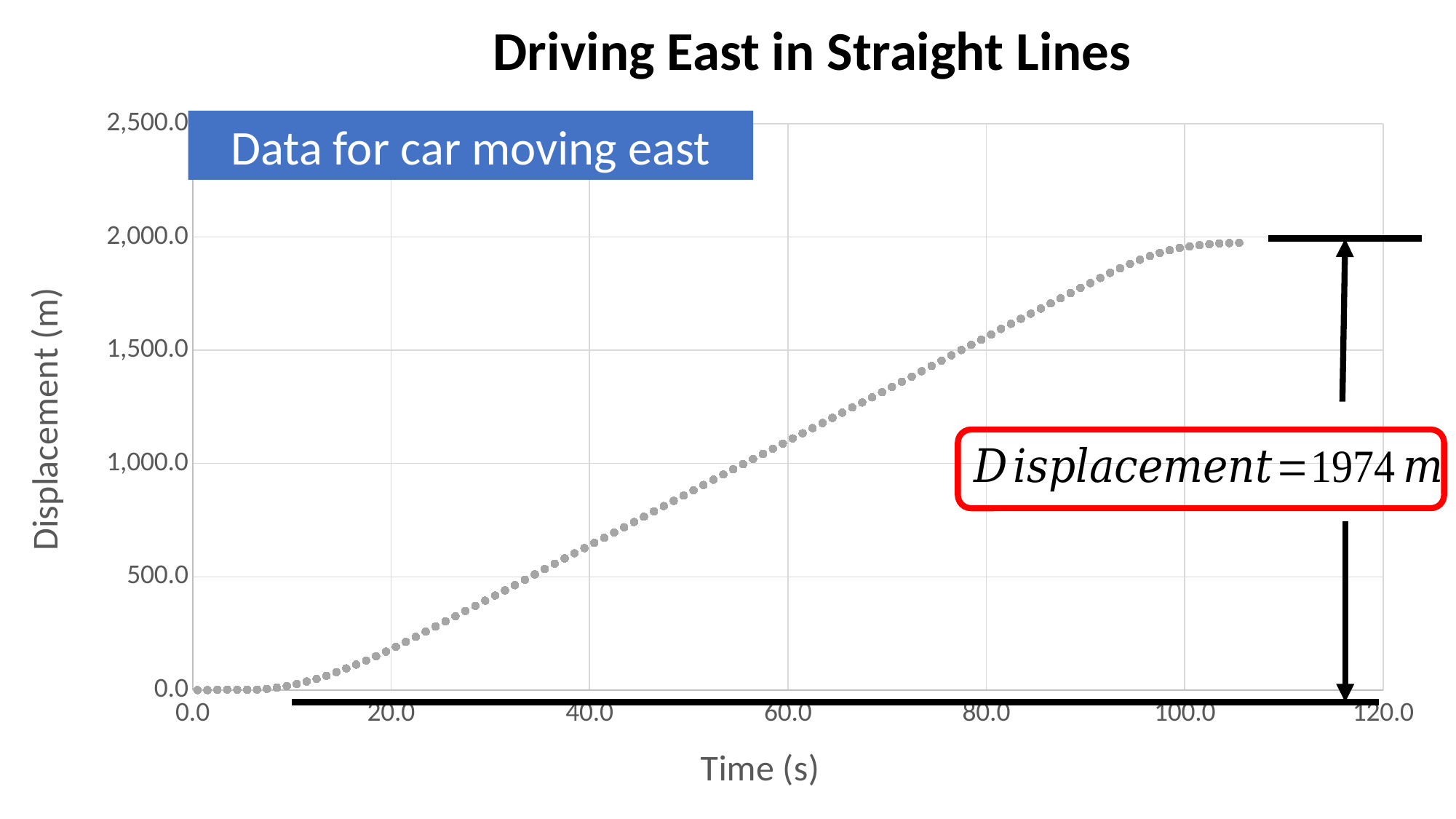
Does the displacement rise or fall as time increases along the x axis? rise Is the displacement at 100.0 s greater or less than 2,000.0? less Is the displacement at 80.0 s greater or less than 1,000.0? greater Is the displacement at 40.0 s greater or less than 500.0? greater What is the label of the vertical axis? Displacement (m) What is the title of the chart? Driving East in Straight Lines What final displacement value is printed in the annotation on the chart? 1974 m Which is larger, the displacement at 20.0 s or the displacement at 80.0 s? 80.0 s What kind of chart is shown on the slide? scatter chart